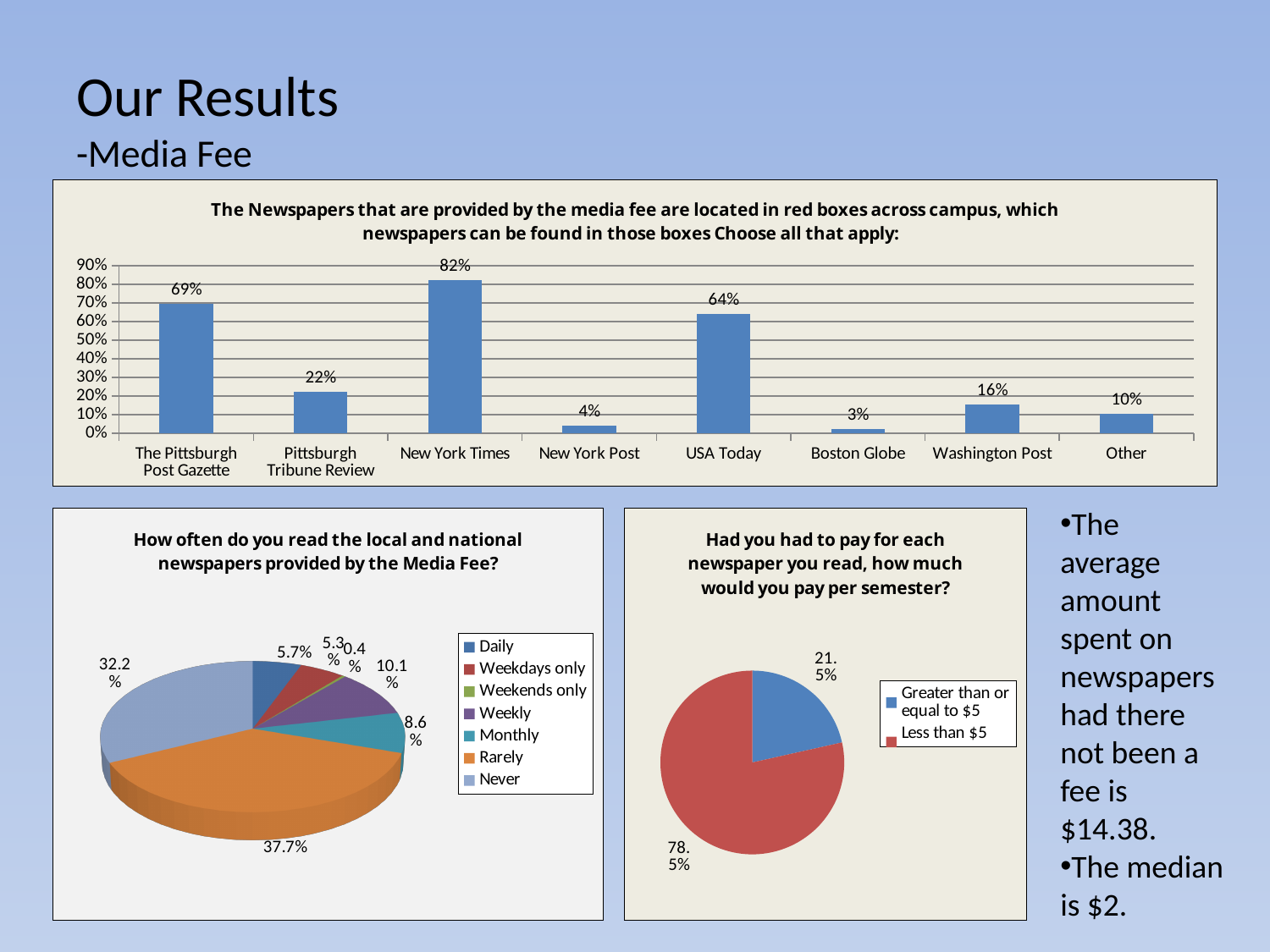
In the top bar chart about newspapers found in the red boxes, how many newspaper categories are shown? 8 In the pie chart 'How often do you read the local and national newspapers provided by the Media Fee?', what share is labelled for Rarely? 37.7% In the top bar chart about newspapers found in the red boxes, which newspaper has the highest percentage? New York Times In the top bar chart about newspapers found in the red boxes, what is the difference between the percentages for The Pittsburgh Post Gazette and Pittsburgh Tribune Review? 47% In the pie chart 'How often do you read the local and national newspapers provided by the Media Fee?', how many categories does the legend list? 7 What type of chart is the top chart about newspapers found in the red boxes? Bar chart In the pie chart 'Had you had to pay for each newspaper you read, how much would you pay per semester?', which slice is larger: Greater than or equal to $5 or Less than $5? Less than $5 In the top bar chart about newspapers found in the red boxes, what percentage is shown for USA Today? 64% In the top bar chart about newspapers found in the red boxes, which newspaper has the lowest percentage? Boston Globe In the top bar chart about newspapers found in the red boxes, which is larger: Washington Post or Other? Washington Post In the pie chart 'Had you had to pay for each newspaper you read, how much would you pay per semester?', what share is labelled for Less than $5? 78.5% In the top bar chart about newspapers found in the red boxes, what percentage is shown for New York Times? 82%